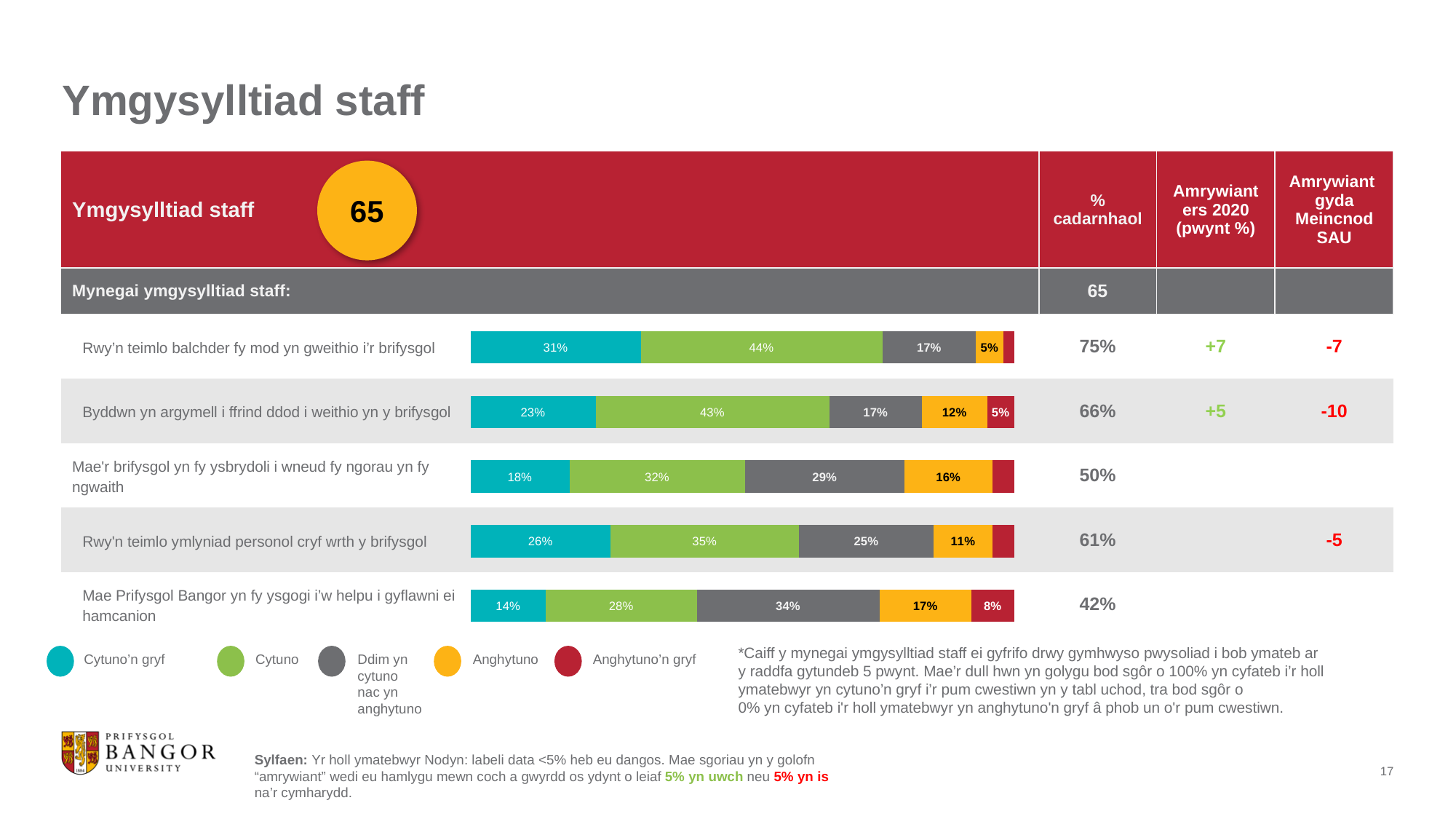
What is the 'Anghytuno' value for 'Rwy'n teimlo ymlyniad personol cryf wrth y brifysgol'? 11% Which is larger: the 'Cytuno' value for 'Mae'r brifysgol yn fy ysbrydoli i wneud fy ngorau yn fy ngwaith' or the 'Cytuno' value for 'Rwy'n teimlo ymlyniad personol cryf wrth y brifysgol'? Rwy'n teimlo ymlyniad personol cryf wrth y brifysgol What kind of chart is shown on the slide? Stacked bar chart What is the 'Cytuno' value for 'Byddwn yn argymell i ffrind ddod i weithio yn y brifysgol'? 43% What is the 'Ddim yn cytuno nac yn anghytuno' value for 'Mae Prifysgol Bangor yn fy ysgogi i'w helpu i gyflawni ei hamcanion'? 34% What is the difference between the 'Cytuno' and 'Cytuno'n gryf' values for 'Rwy'n teimlo balchder fy mod yn gweithio i'r brifysgol'? 13% How many series does the legend list? 5 Which statement has the highest 'Cytuno'n gryf' value? Rwy'n teimlo balchder fy mod yn gweithio i'r brifysgol Which statement has the lowest 'Cytuno'n gryf' value? Mae Prifysgol Bangor yn fy ysgogi i'w helpu i gyflawni ei hamcanion Which colour represents 'Anghytuno'n gryf' in the legend? Red What is the 'Cytuno'n gryf' value for 'Rwy'n teimlo balchder fy mod yn gweithio i'r brifysgol'? 31% How many statements (bars) are plotted in the chart? 5